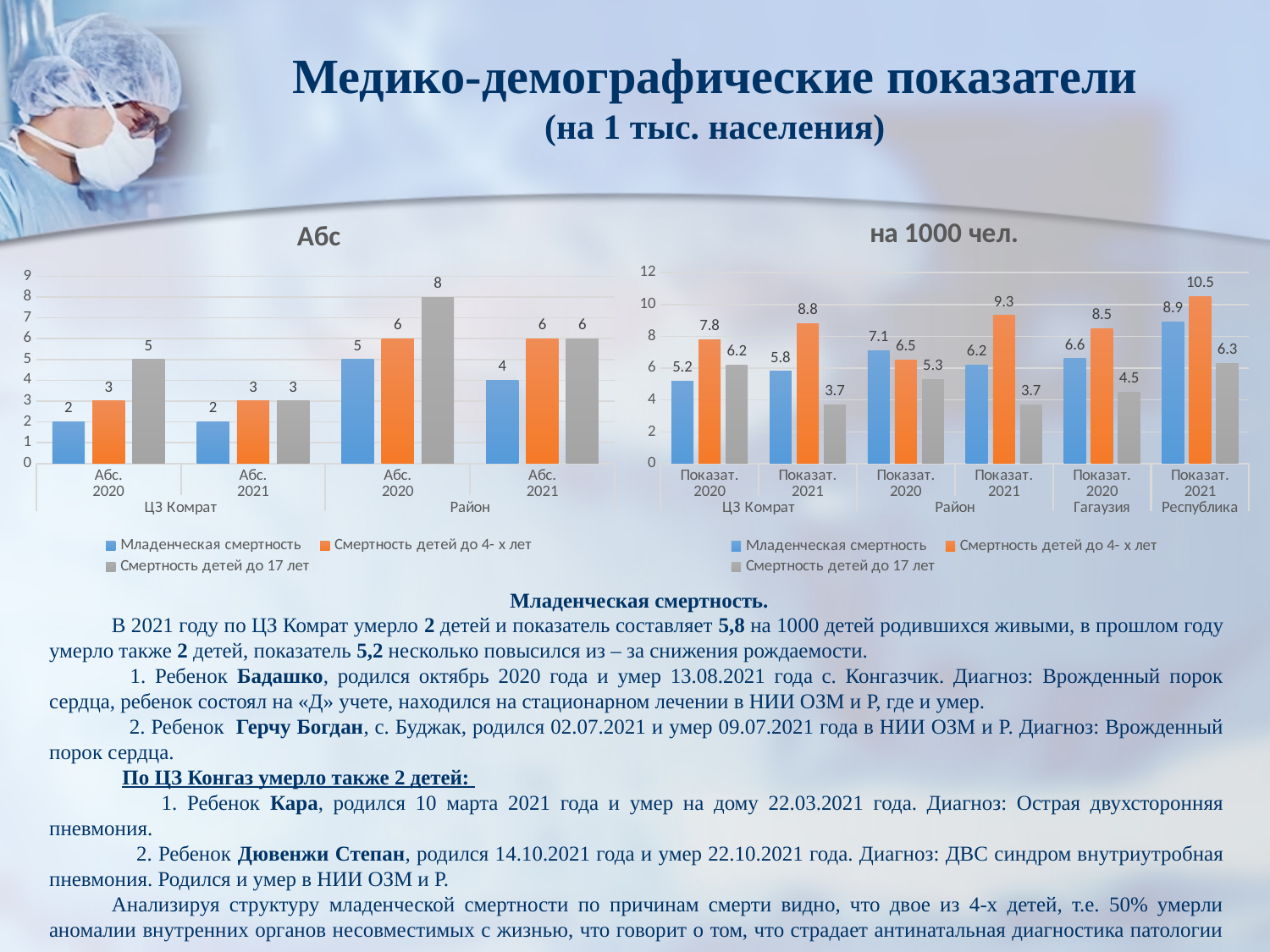
In the chart titled "Абс", which series has the highest value for Район in Абс. 2020? Смертность детей до 17 лет In the chart titled "Абс", what is the value of Младенческая смертность for ЦЗ Комрат in Абс. 2021? 2 In the chart titled "Абс", what is the difference between Смертность детей до 17 лет for Район in Абс. 2020 and Район in Абс. 2021? 2 In the chart titled "на 1000 чел.", what is the difference between Смертность детей до 4- х лет for ЦЗ Комрат in Показат. 2021 and Показат. 2020? 1.0 In the chart titled "на 1000 чел.", which category group has the lowest value of Смертность детей до 17 лет? ЦЗ Комрат Показат. 2021 and Район Показат. 2021 (both 3.7) What type of chart is the chart titled "на 1000 чел."? Bar chart In the chart titled "на 1000 чел.", which is larger: Младенческая смертность for Район in Показат. 2020 or for Гагаузия in Показат. 2020? Район Показат. 2020 In the chart titled "на 1000 чел.", how many category groups are shown on the x axis? 6 In the chart titled "Абс", how many series does the legend list? 3 In the chart titled "на 1000 чел.", what is the value of Смертность детей до 4- х лет for Республика in Показат. 2021? 10.5 In the chart titled "на 1000 чел.", what is the value of Младенческая смертность for ЦЗ Комрат in Показат. 2021? 5.8 In the chart titled "Абс", what is the value of Смертность детей до 17 лет for Район in Абс. 2020? 8